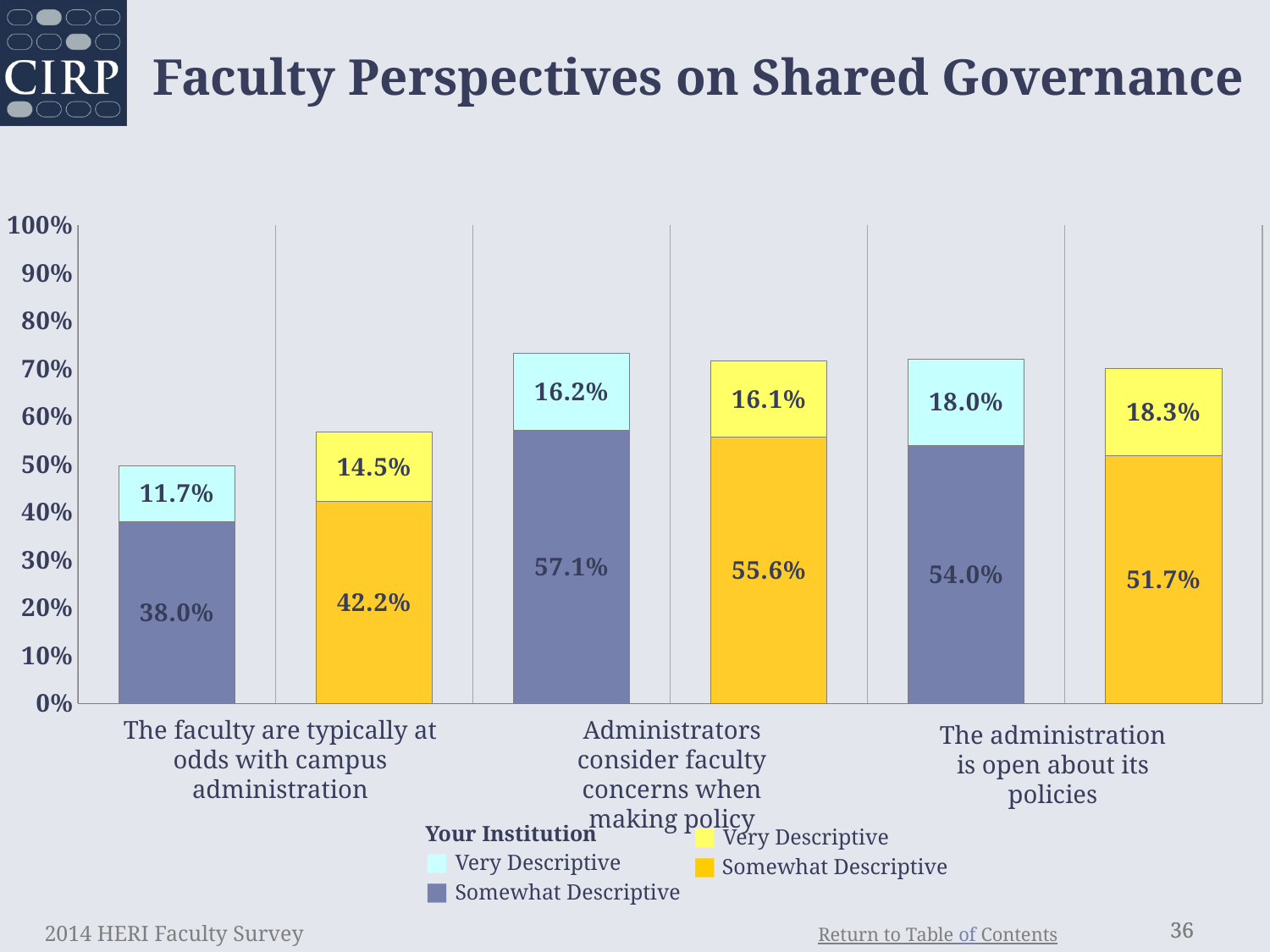
In the yellow comparison-group bar for "Administrators consider faculty concerns when making policy", what is the Very Descriptive value? 16.1% How many series does the legend list? 4 What percentage of faculty at Your Institution rated "The faculty are typically at odds with campus administration" as Somewhat Descriptive? 38.0% How many statements (categories) are shown on the x axis? 3 What is the Your Institution Very Descriptive value for "The administration is open about its policies"? 18.0% For "The administration is open about its policies", which Somewhat Descriptive value is larger: Your Institution or the orange comparison group? Your Institution (54.0%) How much higher is the Your Institution Somewhat Descriptive value for "Administrators consider faculty concerns when making policy" than for "The faculty are typically at odds with campus administration"? 19.1 percentage points What is the total of the yellow/orange comparison-group stacked bar for "The faculty are typically at odds with campus administration"? 56.7% What is the total height of the Your Institution stacked bar for "Administrators consider faculty concerns when making policy"? 73.3% Which statement has the lowest Your Institution Very Descriptive value? The faculty are typically at odds with campus administration What kind of chart is shown on the slide? Stacked bar chart Which statement has the highest Your Institution Somewhat Descriptive value? Administrators consider faculty concerns when making policy